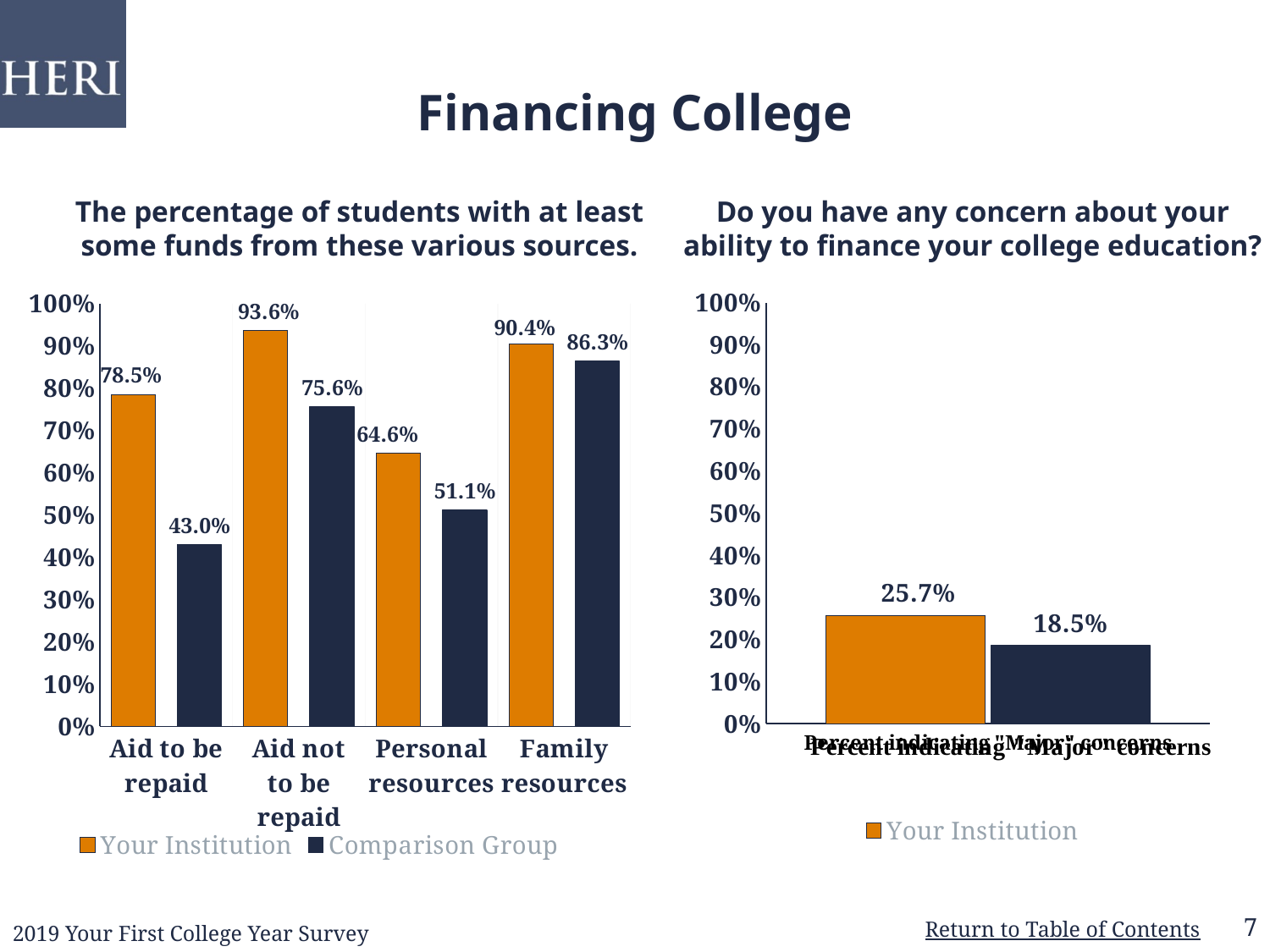
In the right chart, what is the difference between the two bars, 25.7% and 18.5%? 7.2% In the left chart, what is the difference between Your Institution and Comparison Group for Aid to be repaid? 35.5% In the left chart, which category has the highest Your Institution value? Aid not to be repaid In the left chart, which is larger for Family resources: Your Institution or Comparison Group? Your Institution In the left chart, which series is shown in orange? Your Institution What kind of chart is the chart on the right? Bar chart In the left chart, how many categories are shown on the x axis? 4 In the left chart, what is the value for Comparison Group for Personal resources? 51.1% In the left chart, what is the value for Your Institution for Aid to be repaid? 78.5% In the left chart, which category has the lowest Comparison Group value? Aid to be repaid In the right chart, what is the value of the orange (Your Institution) bar? 25.7% In the left chart, how many series does the legend list? 2